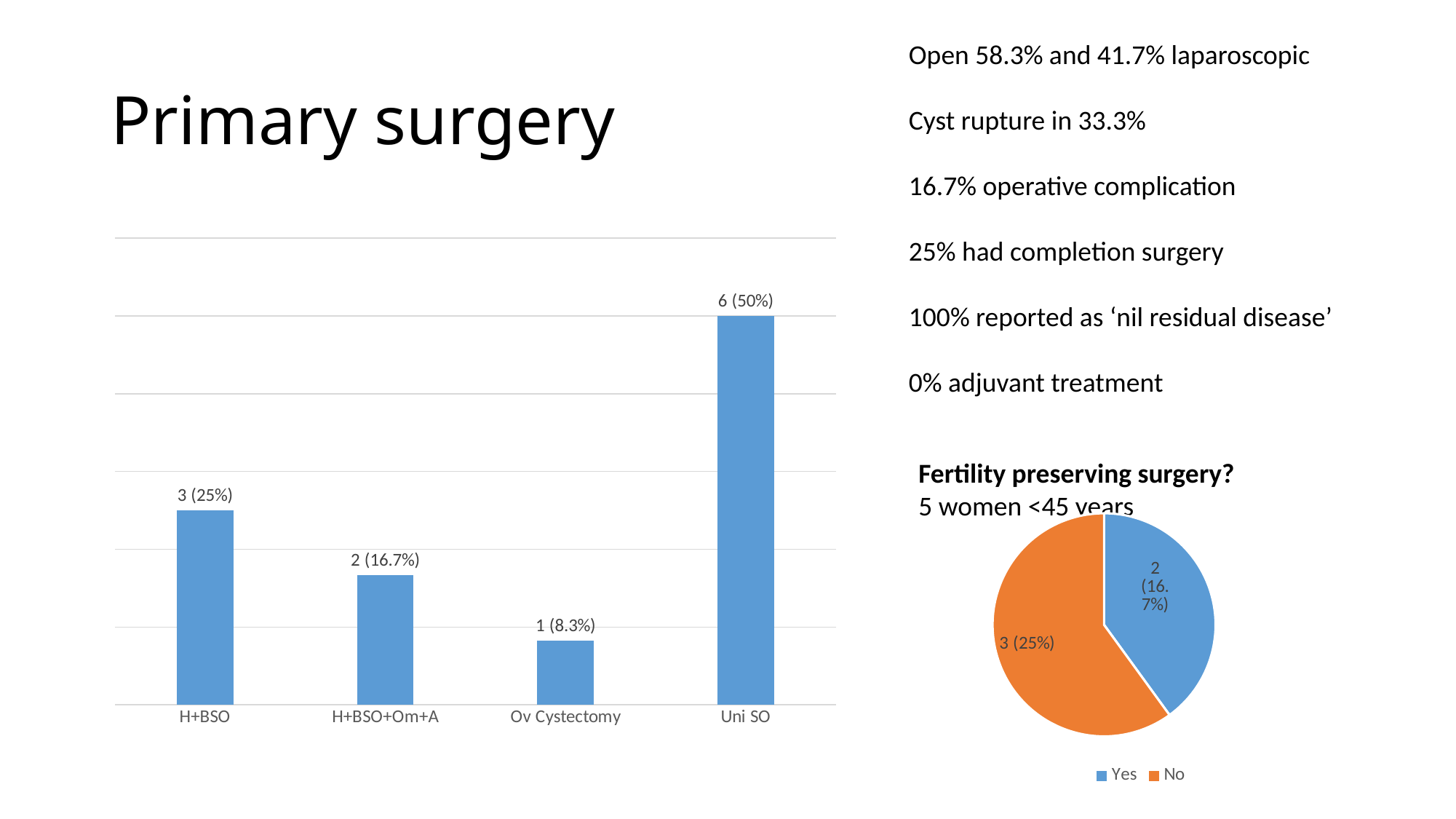
How many entries does the legend of the pie chart titled 'Fertility preserving surgery?' list? 2 In the pie chart titled 'Fertility preserving surgery?', what is the value shown for the No slice? 3 (25%) In the bar chart on the left of the slide, what is the value shown for Uni SO? 6 (50%) In the bar chart on the left of the slide, which is larger, H+BSO or H+BSO+Om+A? H+BSO How many categories are shown in the bar chart on the left of the slide? 4 In the bar chart on the left of the slide, which category has the lowest value? Ov Cystectomy In the bar chart on the left of the slide, what is the difference in count between Uni SO and H+BSO? 3 What kind of chart is on the left of the slide? Bar chart In the bar chart on the left of the slide, what is the value shown for Ov Cystectomy? 1 (8.3%) In the bar chart on the left of the slide, which category has the highest value? Uni SO In the pie chart titled 'Fertility preserving surgery?', which slice is larger, Yes or No? No In the bar chart on the left of the slide, what is the value shown for H+BSO+Om+A? 2 (16.7%)